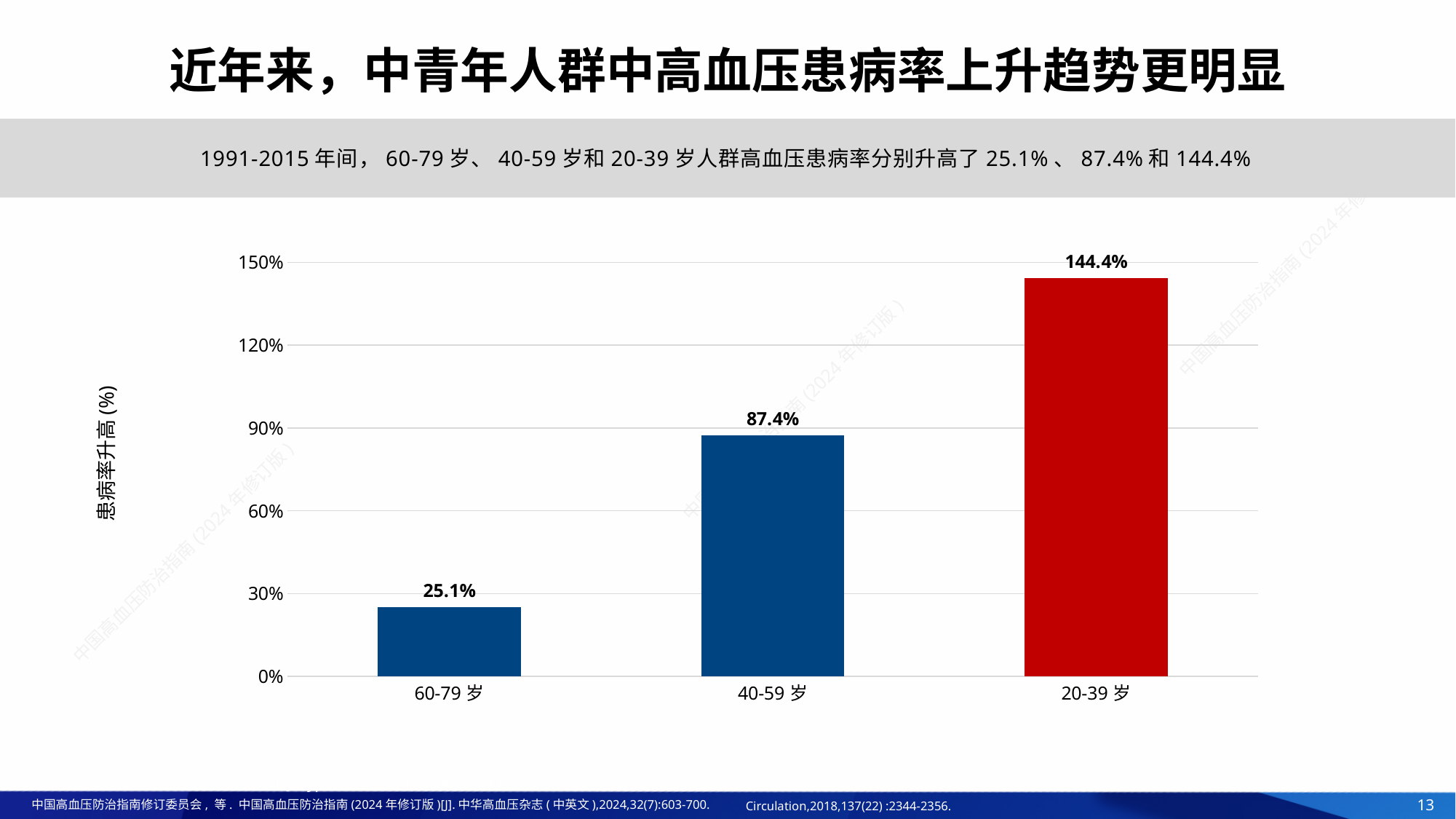
What kind of chart is shown on the slide? bar chart Is the value for 40-59 岁 greater or less than 90%? less What is the value for the 20-39 岁 group? 144.4% What is the difference between the values for 40-59 岁 and 60-79 岁? 62.3% What is the value for the 60-79 岁 group? 25.1% What is the label of the vertical axis? 患病率升高 (%) What is the difference between the values for 20-39 岁 and 40-59 岁? 57.0% How many age groups are shown in the chart? 3 Which age group has the lowest value? 60-79 岁 Which is larger, the value for 40-59 岁 or the value for 60-79 岁? 40-59 岁 What is the value for the 40-59 岁 group? 87.4% Which age group has the highest value? 20-39 岁